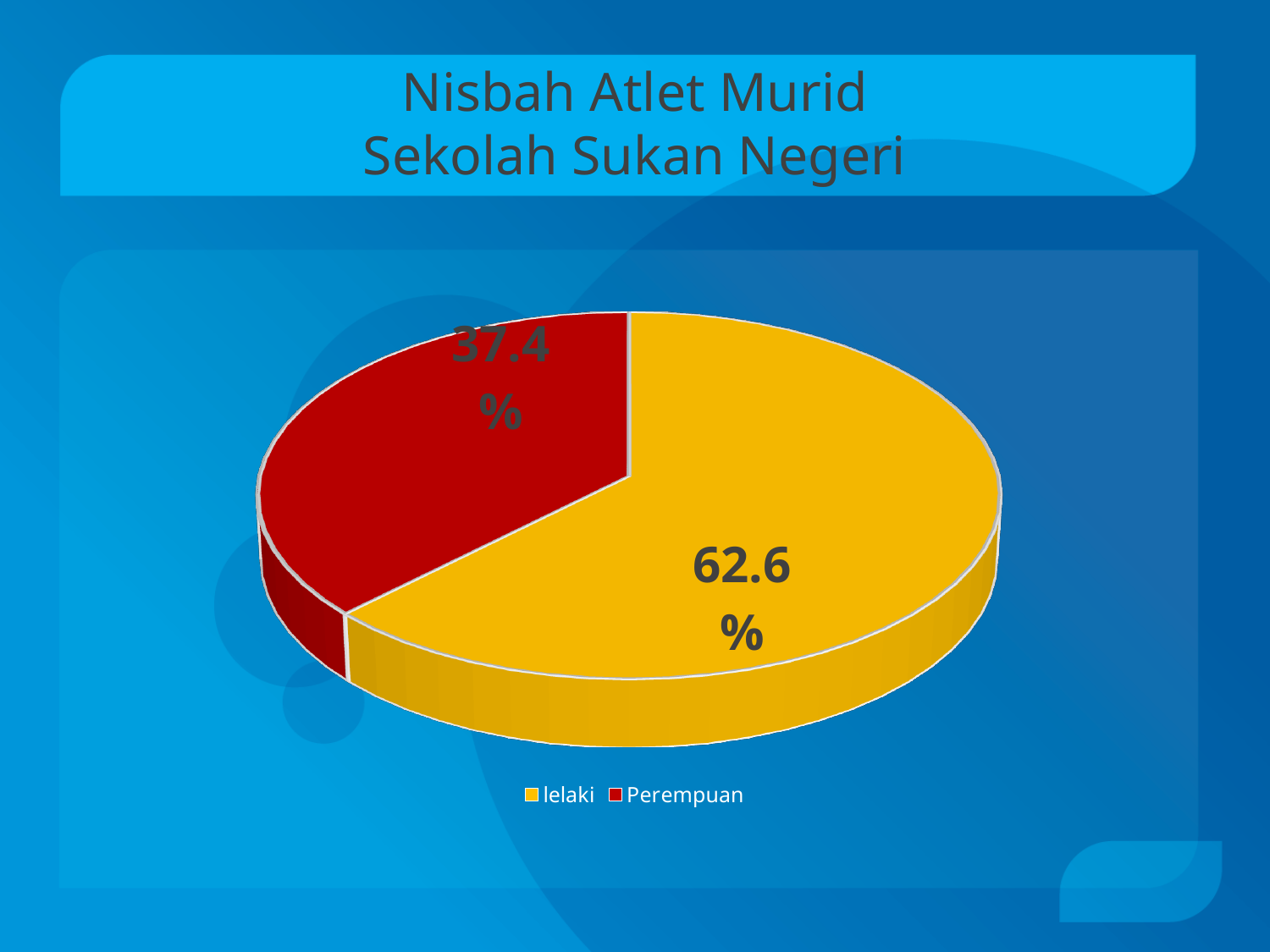
How many slices does the pie chart have? 2 Which is larger, the lelaki slice or the Perempuan slice? lelaki What is the title of the slide? Nisbah Atlet Murid Sekolah Sukan Negeri What colour is the Perempuan slice? Red Which category has the largest share of the pie? lelaki What percentage of the pie is the lelaki slice? 62.6% Which category has the smallest share of the pie? Perempuan What kind of chart is shown on the slide? Pie chart What is the difference in percentage points between the lelaki and Perempuan slices? 25.2 What percentage of the pie is the Perempuan slice? 37.4% How many entries does the legend list? 2